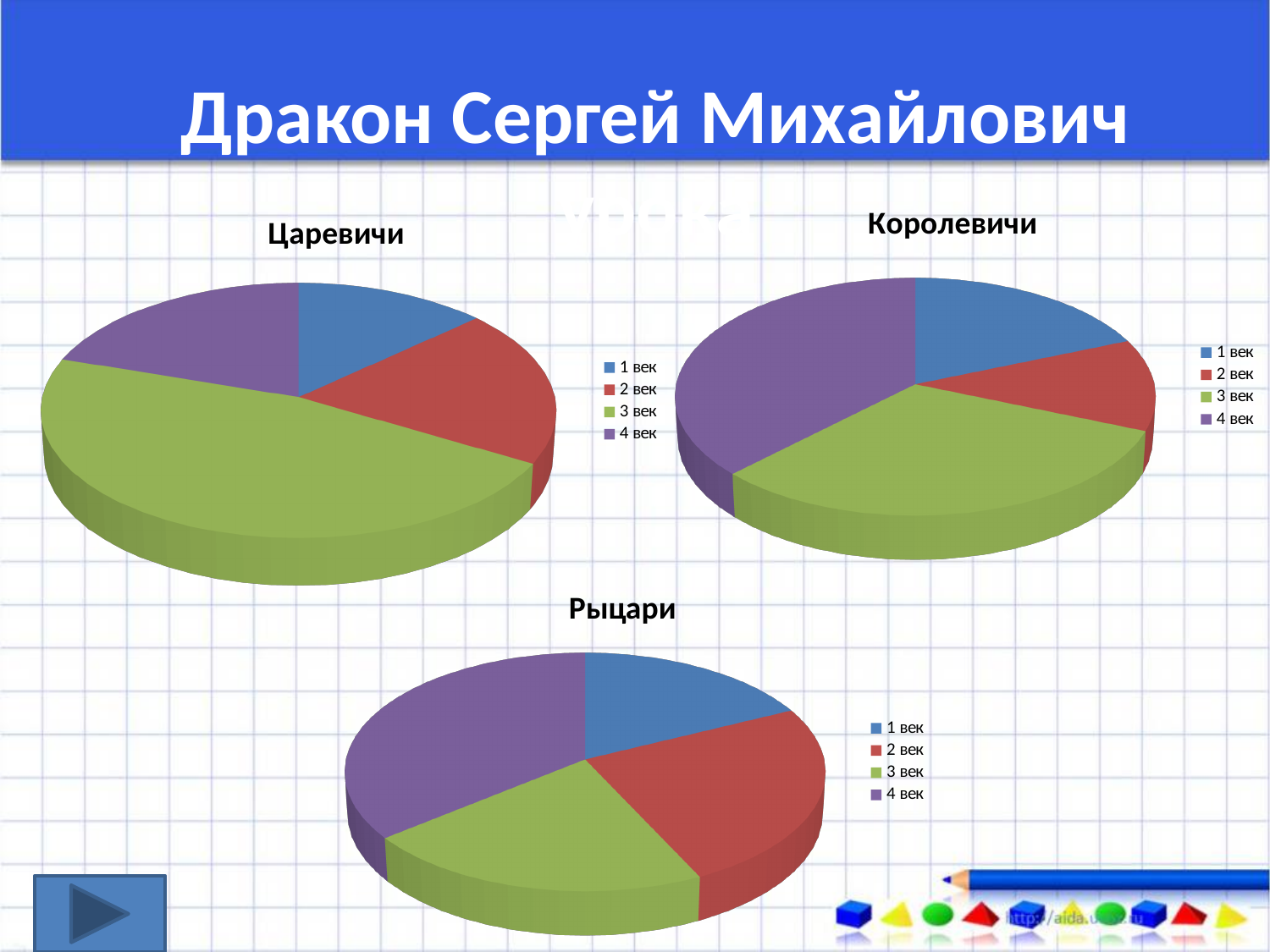
In the "Царевичи" chart, which category has the smallest slice? 1 век Which colour represents "3 век" in the legend of the "Царевичи" chart? green How many entries does the legend of the "Королевичи" chart list? 4 How many pie charts are shown on the slide? 3 In the "Рыцари" chart, which category has the smallest slice? 1 век What is the title of the pie chart at the bottom of the slide? Рыцари In the "Рыцари" chart, which category has the largest slice? 4 век What kind of chart is the "Царевичи" chart? pie chart In the "Королевичи" chart, which slice is larger: 1 век or 2 век? 1 век In the "Королевичи" chart, which category has the smallest slice? 2 век How many slices does the "Рыцари" pie chart have? 4 In the "Царевичи" chart, which category has the largest slice? 3 век